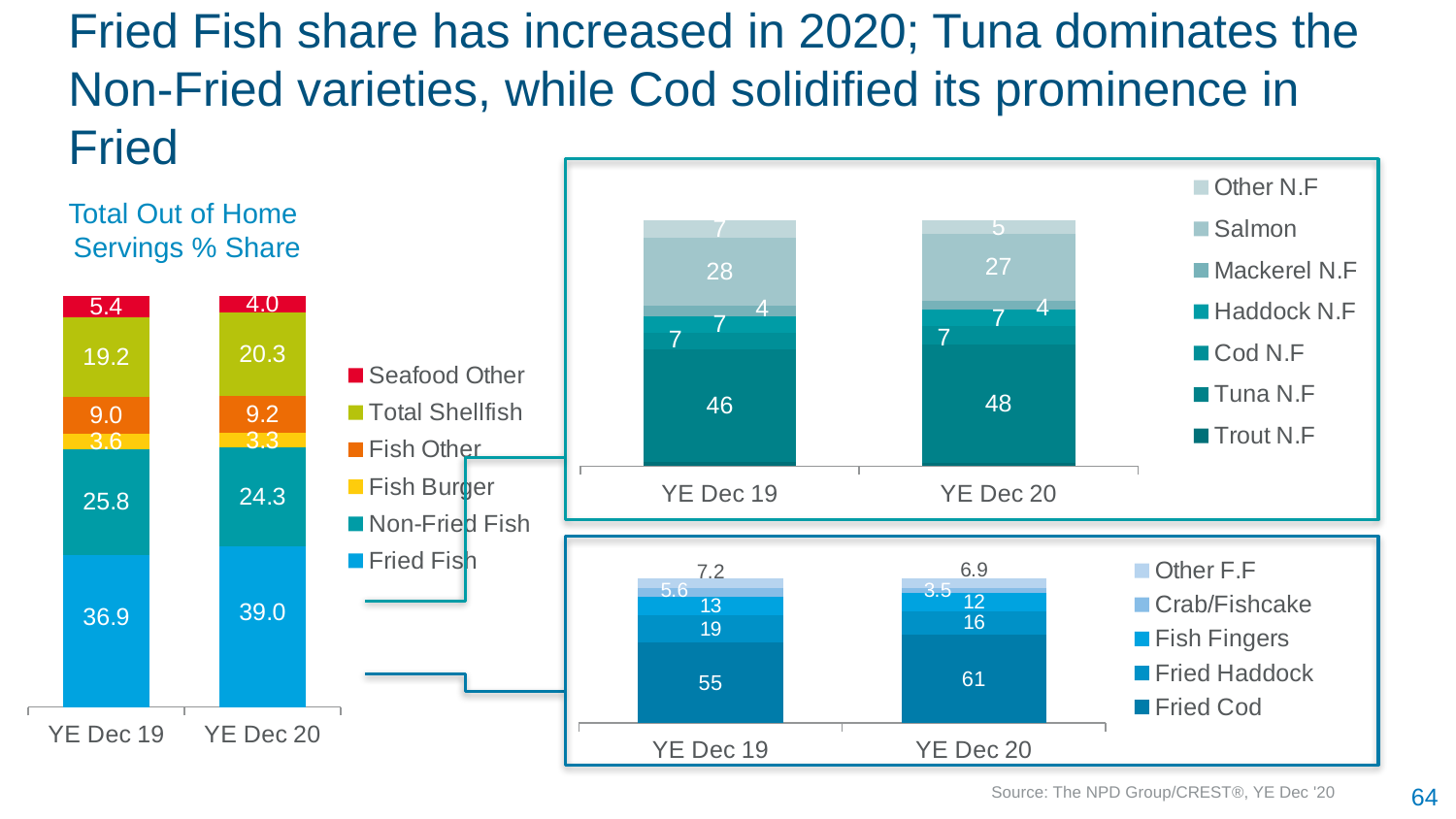
In the 'Total Out of Home Servings % Share' chart on the left, what is the value for Fried Fish in YE Dec 20? 39.0 In the 'Total Out of Home Servings % Share' chart on the left, what is the value for Non-Fried Fish in YE Dec 19? 25.8 In the bottom-right chart (Fried Fish breakdown), what is the value for Fried Cod in YE Dec 20? 61 In the 'Total Out of Home Servings % Share' chart on the left, by how much did the Fried Fish value change from YE Dec 19 to YE Dec 20? 2.1 What type of chart is the bottom-right chart (Fried Fish breakdown)? Stacked bar chart In the top-right chart (Non-Fried Fish breakdown), is the Tuna N.F value larger in YE Dec 19 or YE Dec 20? YE Dec 20 How many series does the legend of the 'Total Out of Home Servings % Share' chart on the left list? 6 In the 'Total Out of Home Servings % Share' chart on the left, which series has the smallest value in YE Dec 20? Fish Burger In the top-right chart (Non-Fried Fish breakdown), what is the value for Salmon in YE Dec 19? 28 In the 'Total Out of Home Servings % Share' chart on the left, which series has the largest value in YE Dec 20? Fried Fish In the top-right chart (Non-Fried Fish breakdown), what is the value for Tuna N.F in YE Dec 20? 48 In the bottom-right chart (Fried Fish breakdown), what is the difference between the Fried Haddock values for YE Dec 19 and YE Dec 20? 3